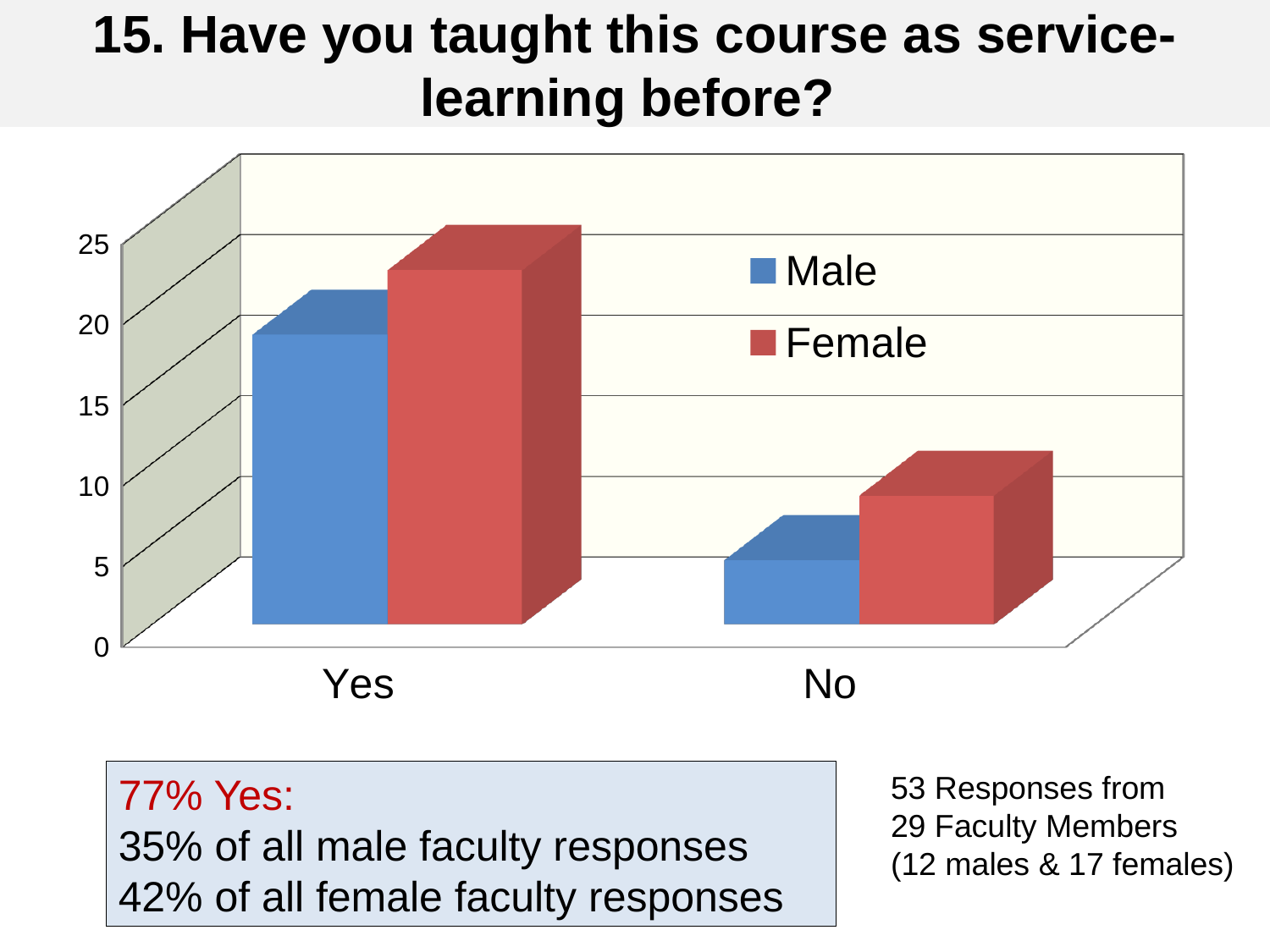
What kind of chart is shown on the slide? bar chart How many series does the chart legend list? 2 Which bar is the tallest in the chart? Female, Yes Which series is shown in red in the chart? Female How many categories are shown on the x axis of the chart? 2 Is the Female value for No greater or less than 5? greater Which series is shown in blue in the chart? Male For the Yes category, which is larger: the Male bar or the Female bar? Female Is the Male value for No greater or less than 10? less Which bar is the shortest in the chart? Male, No For the Male series, which category has the larger value: Yes or No? Yes Is the Male value for Yes greater or less than 15? greater